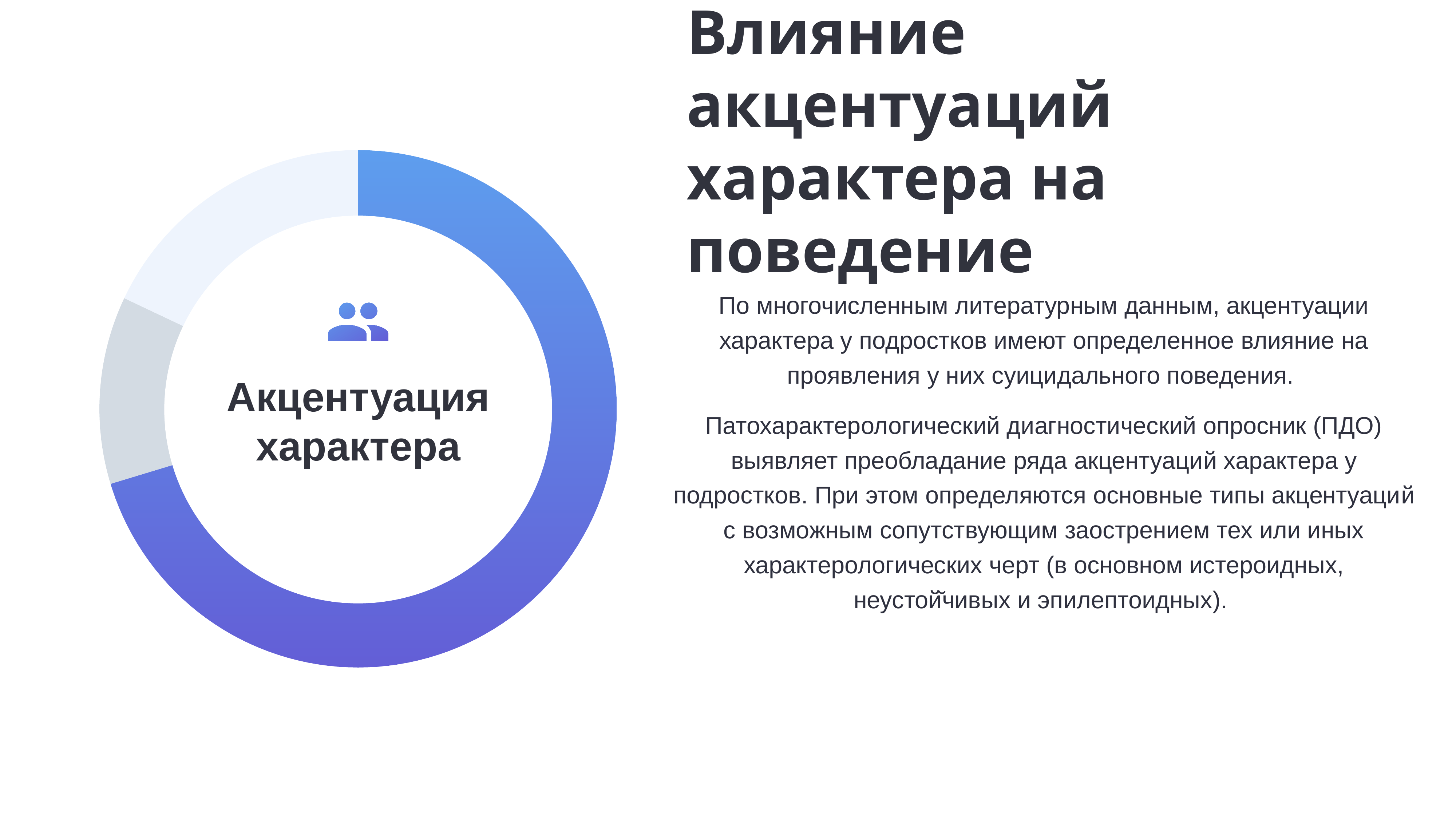
Which colour segment of the donut chart is the largest? The blue segment Is the blue segment of the donut chart larger or smaller than half of the ring? Larger Does the donut chart display any numeric data labels on its segments? No What kind of chart is shown on the left of the slide? Donut (pie) chart What text is written in the centre of the donut chart? Акцентуация характера How many segments does the donut chart on the left contain? 3